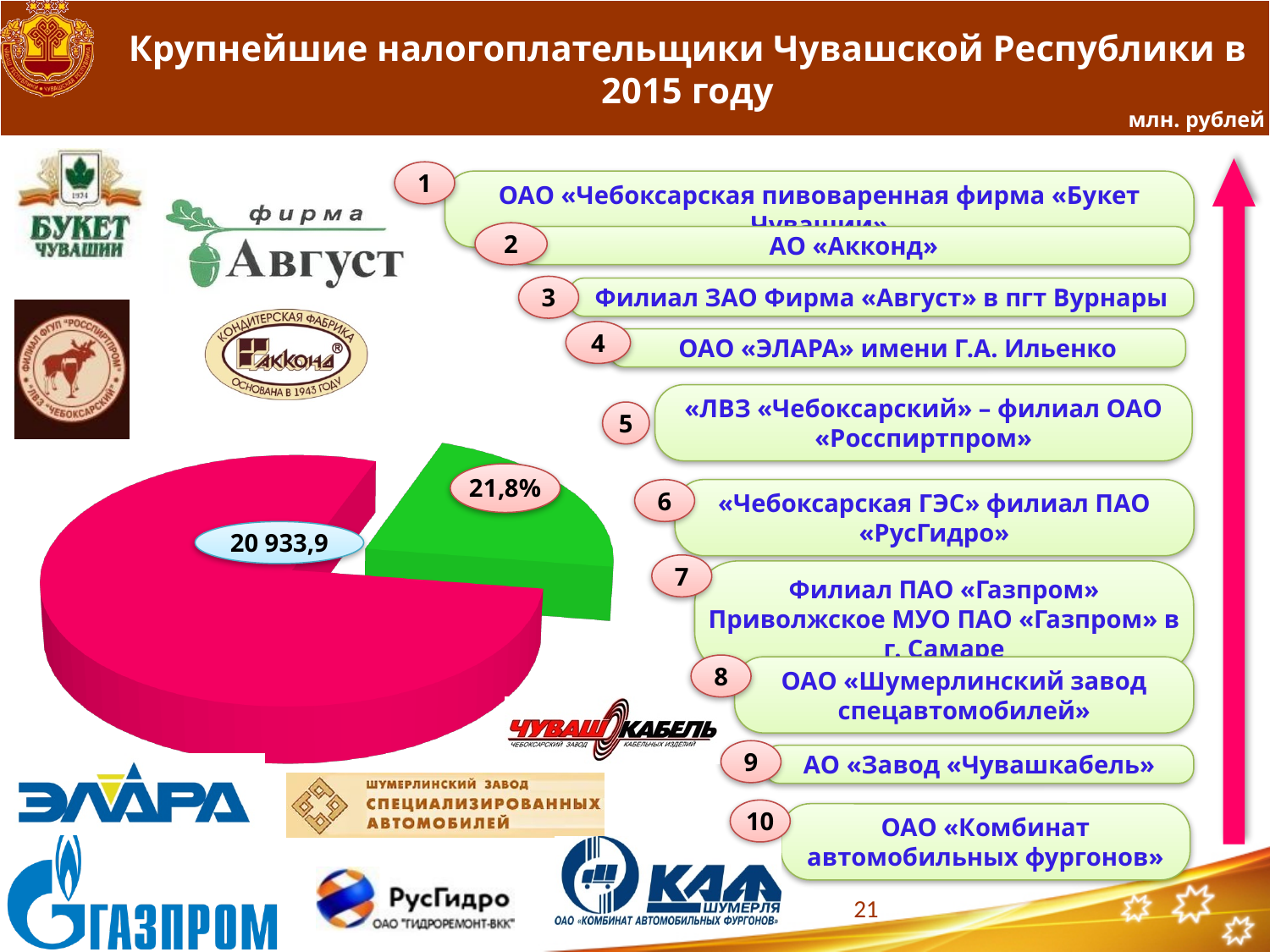
Is the share of the green slice greater or less than 25%? less What kind of chart is shown on the slide? pie chart Which slice of the pie chart is larger, the pink one or the green one? the pink one How many slices does the pie chart have? 2 What percentage is printed on the green slice of the pie chart? 21,8% What unit of measurement is stated for the values on the slide? млн. рублей What share of the pie does the green slice represent? 21,8% What colours are the two slices of the pie chart? pink and green Which slice of the pie chart is the smallest? the green slice What value is printed on the large pink slice of the pie chart? 20 933,9